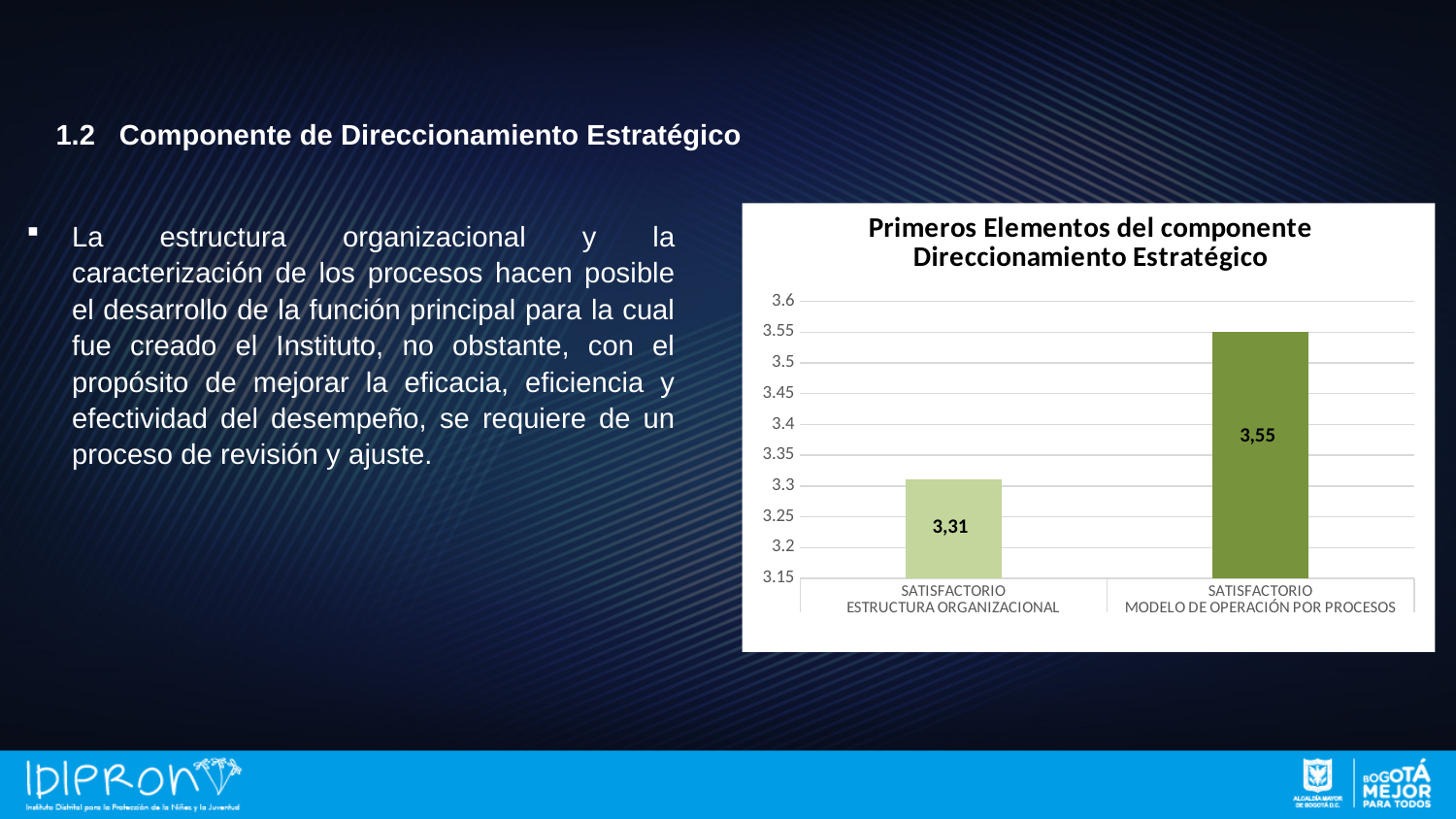
Which category has the lowest value? SATISFACTORIO ESTRUCTURA ORGANIZACIONAL What is the value for SATISFACTORIO ESTRUCTURA ORGANIZACIONAL? 3,31 What kind of chart is shown on the slide? bar chart What is the difference between the values for MODELO DE OPERACIÓN POR PROCESOS and ESTRUCTURA ORGANIZACIONAL? 0,24 Is the value for SATISFACTORIO MODELO DE OPERACIÓN POR PROCESOS greater or less than 3.5? greater Which is larger: the value for ESTRUCTURA ORGANIZACIONAL or the value for MODELO DE OPERACIÓN POR PROCESOS? MODELO DE OPERACIÓN POR PROCESOS How many categories are shown in the chart? 2 What is the lowest value shown on the chart's vertical axis? 3.15 Is the value for SATISFACTORIO ESTRUCTURA ORGANIZACIONAL greater or less than 3.4? less What is the title of the chart? Primeros Elementos del componente Direccionamiento Estratégico Which category has the highest value? SATISFACTORIO MODELO DE OPERACIÓN POR PROCESOS What is the value for SATISFACTORIO MODELO DE OPERACIÓN POR PROCESOS? 3,55